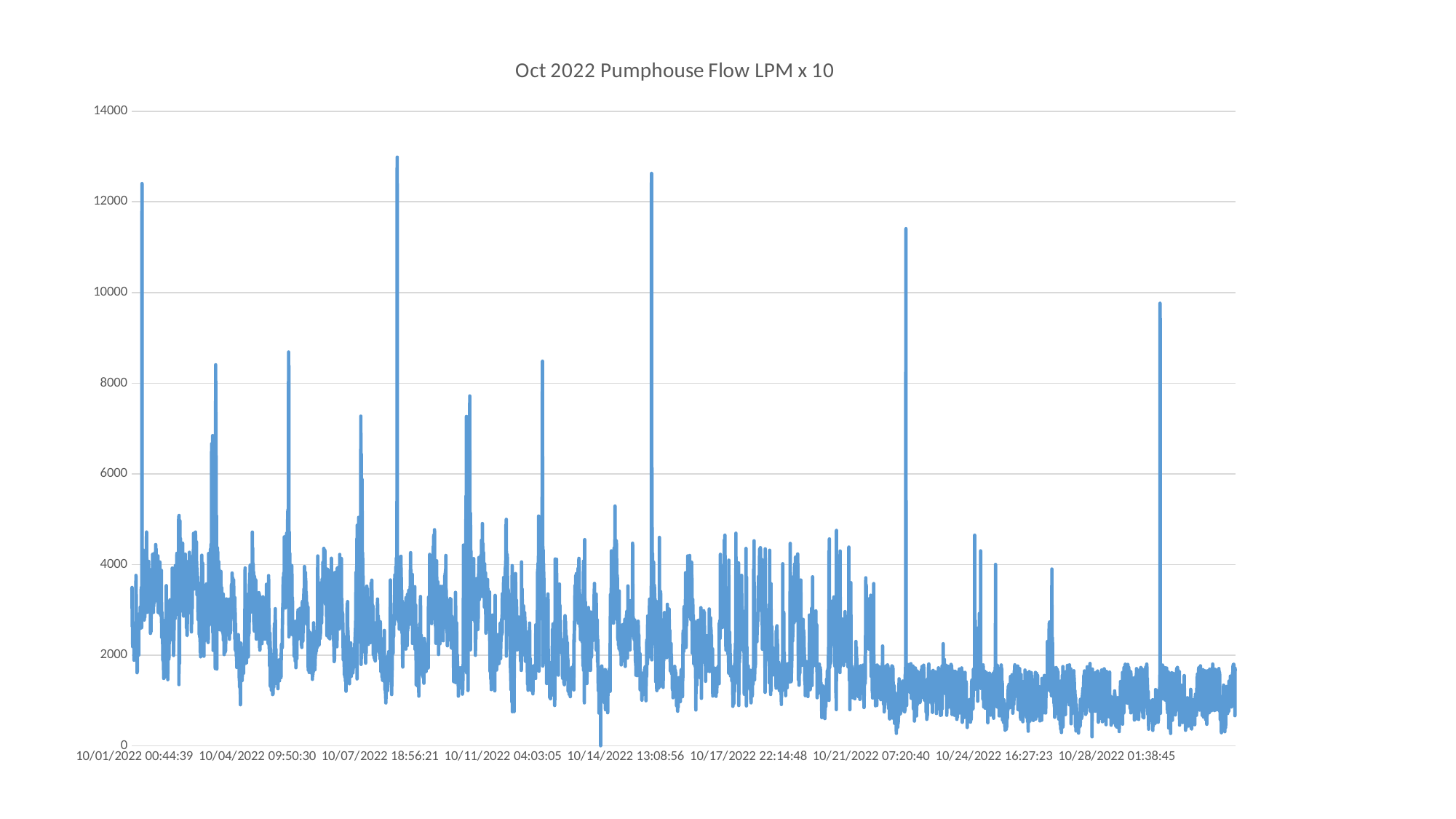
Is the spike near 10/21/2022 07:20:40 greater or less than 10000? greater Is the spike near 10/28/2022 01:38:45 greater or less than 8000? greater What is the first date label on the x axis? 10/01/2022 00:44:39 How many lines (data series) are plotted on the chart? 1 Are the typical values in the last few days of the month greater or less than 2000? less What is the highest value labelled on the y axis? 14000 How many date labels are shown along the x axis? 9 Do the typical flow values rise or fall from the start of the month to the end? fall What kind of chart is shown on the slide? line chart What is the title of the chart? Oct 2022 Pumphouse Flow LPM x 10